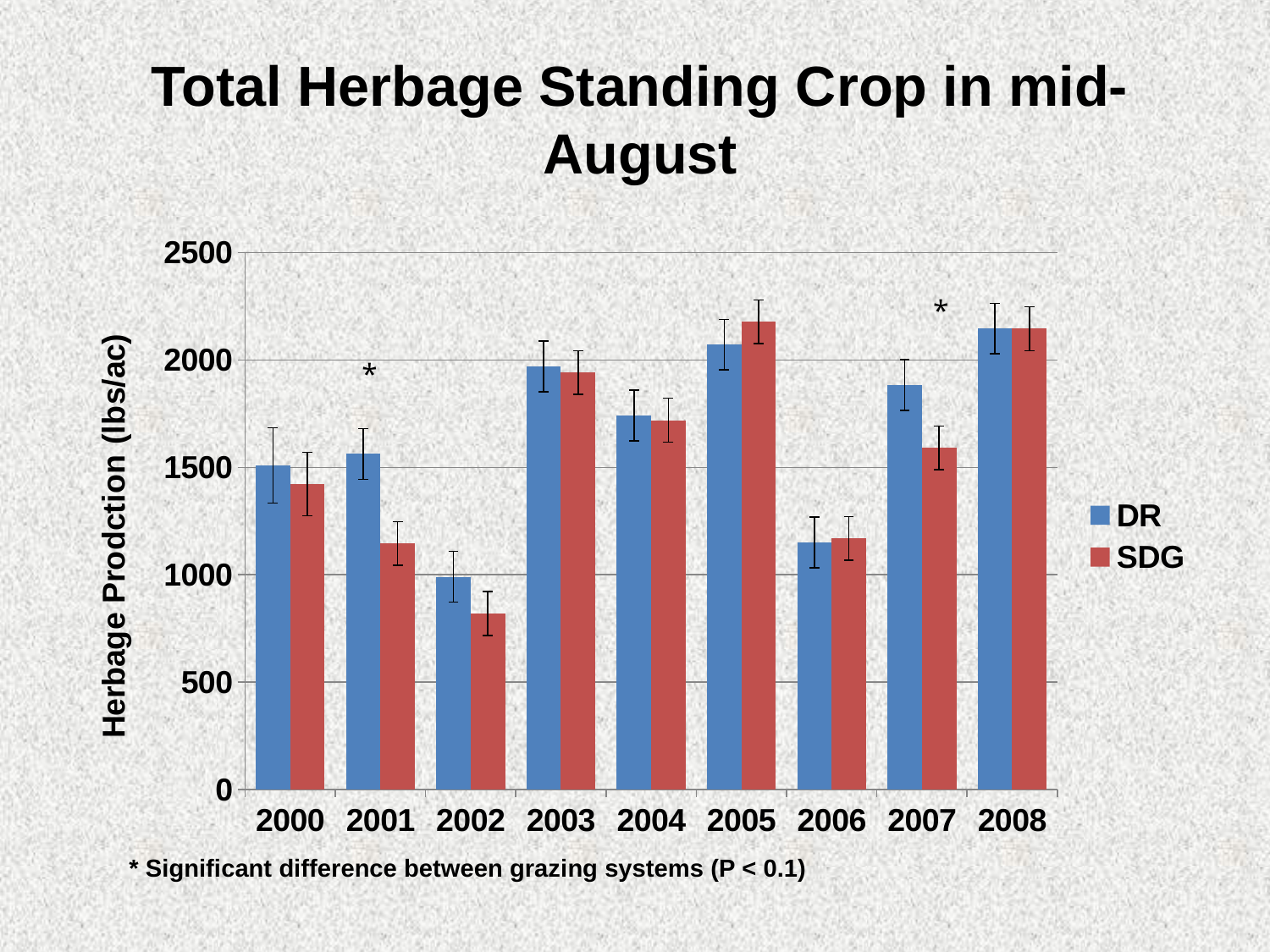
Is the DR value for 2006 greater or less than 1500? less In 2001, which grazing system has the larger value, DR or SDG? DR How many years are shown on the x axis? 9 Is the SDG value for 2002 greater or less than 1000? less Is the SDG value for 2005 greater or less than 2000? greater How many series does the legend list? 2 Which year has the lowest DR value? 2002 Which year has the lowest SDG value? 2002 In 2007, which grazing system has the larger value, DR or SDG? DR What kind of chart is shown on the slide? bar chart Which year has the highest DR value? 2008 What is the label on the y axis? Herbage Prodction (lbs/ac)